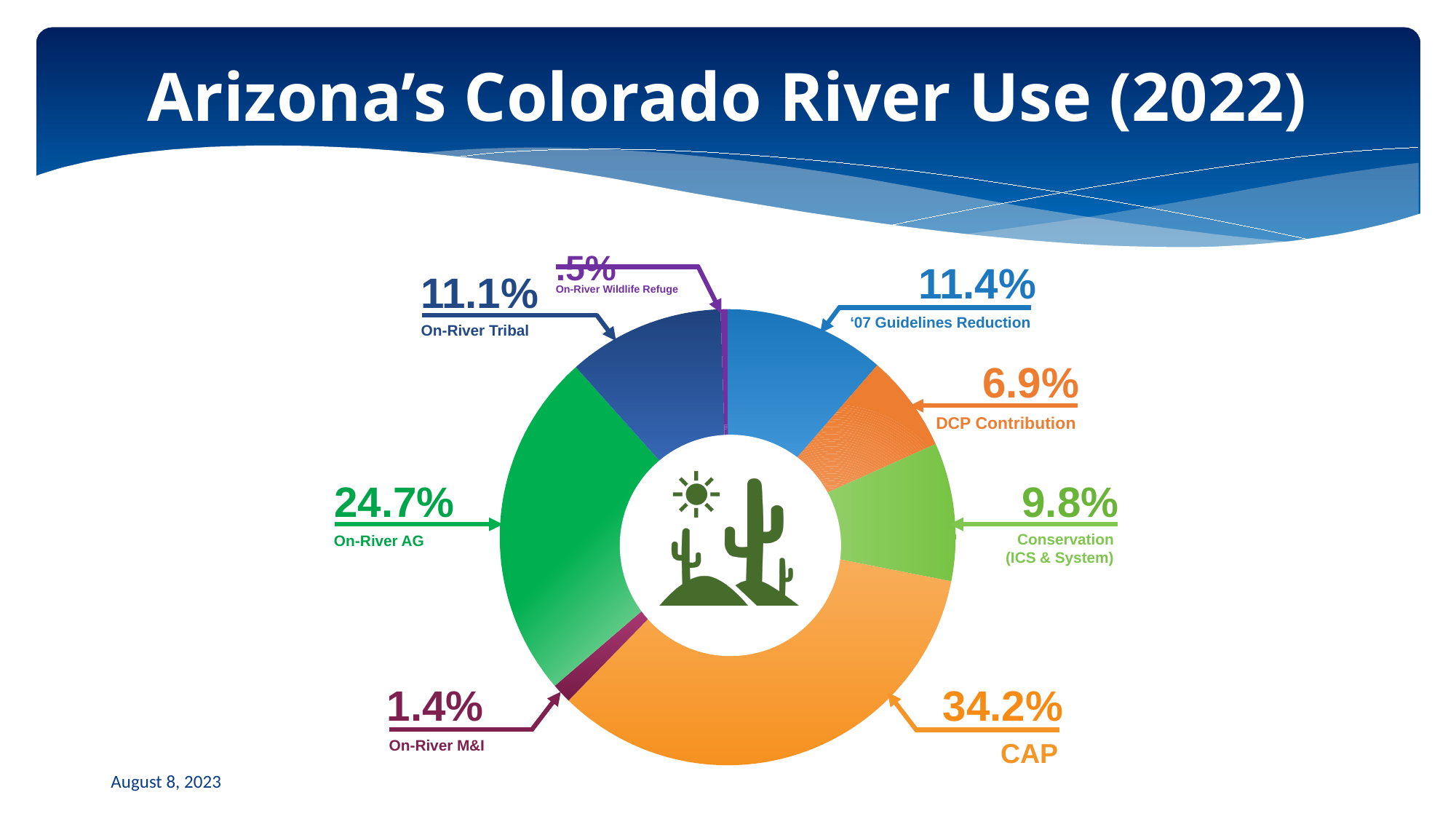
Which category has the smallest share of the chart? On-River Wildlife Refuge What percentage is shown for DCP Contribution? 6.9% What is the difference in percentage points between CAP and On-River AG? 9.5 Which category has the largest share of the chart? CAP What is the title of the slide? Arizona's Colorado River Use (2022) What percentage is shown for Conservation (ICS & System)? 9.8% What percentage is shown for On-River AG? 24.7% What is the combined share of On-River M&I and On-River Wildlife Refuge? 1.9% What kind of chart is shown on the slide? Pie chart (donut) What share of Arizona's Colorado River use is CAP? 34.2% How many categories are shown in the chart? 8 Which is larger, '07 Guidelines Reduction or On-River Tribal? '07 Guidelines Reduction